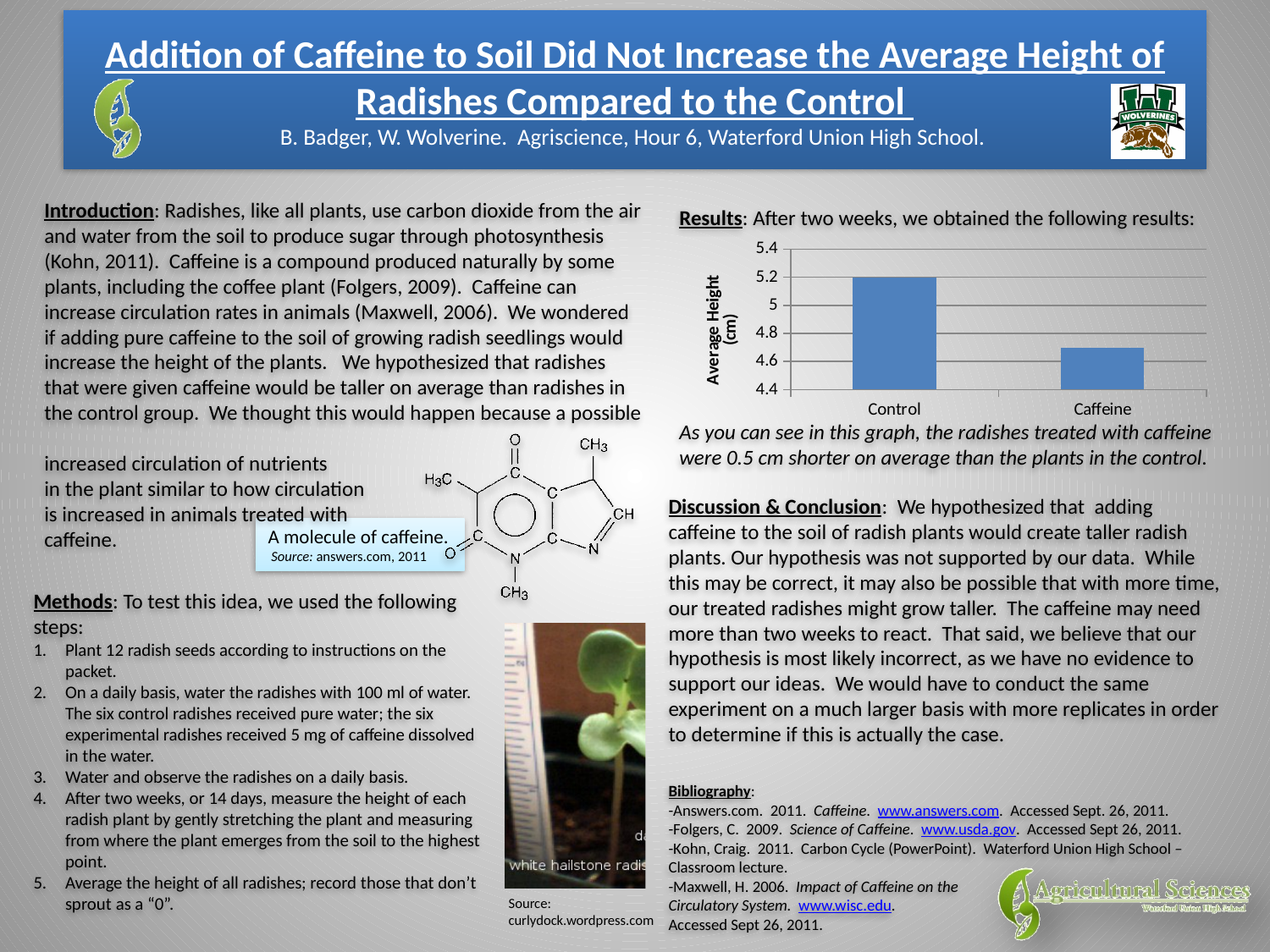
Which category has the highest average height in the Results chart? Control What is the average height (cm) for the Control group in the Results chart? 5.2 Is the average height for Control greater or less than 5 cm? greater Is the average height for Caffeine greater or less than 4.6 cm? greater Which has a larger average height, Control or Caffeine? Control What is the label on the y axis of the Results chart? Average Height (cm) What kind of chart is shown in the Results section? bar chart How many categories are plotted in the Results bar chart? 2 What colour are the bars in the Results chart? blue Do the bar values rise or fall going from Control to Caffeine along the x axis? fall Which category has the lowest average height in the Results chart? Caffeine Is the average height for Caffeine greater or less than 4.8 cm? less